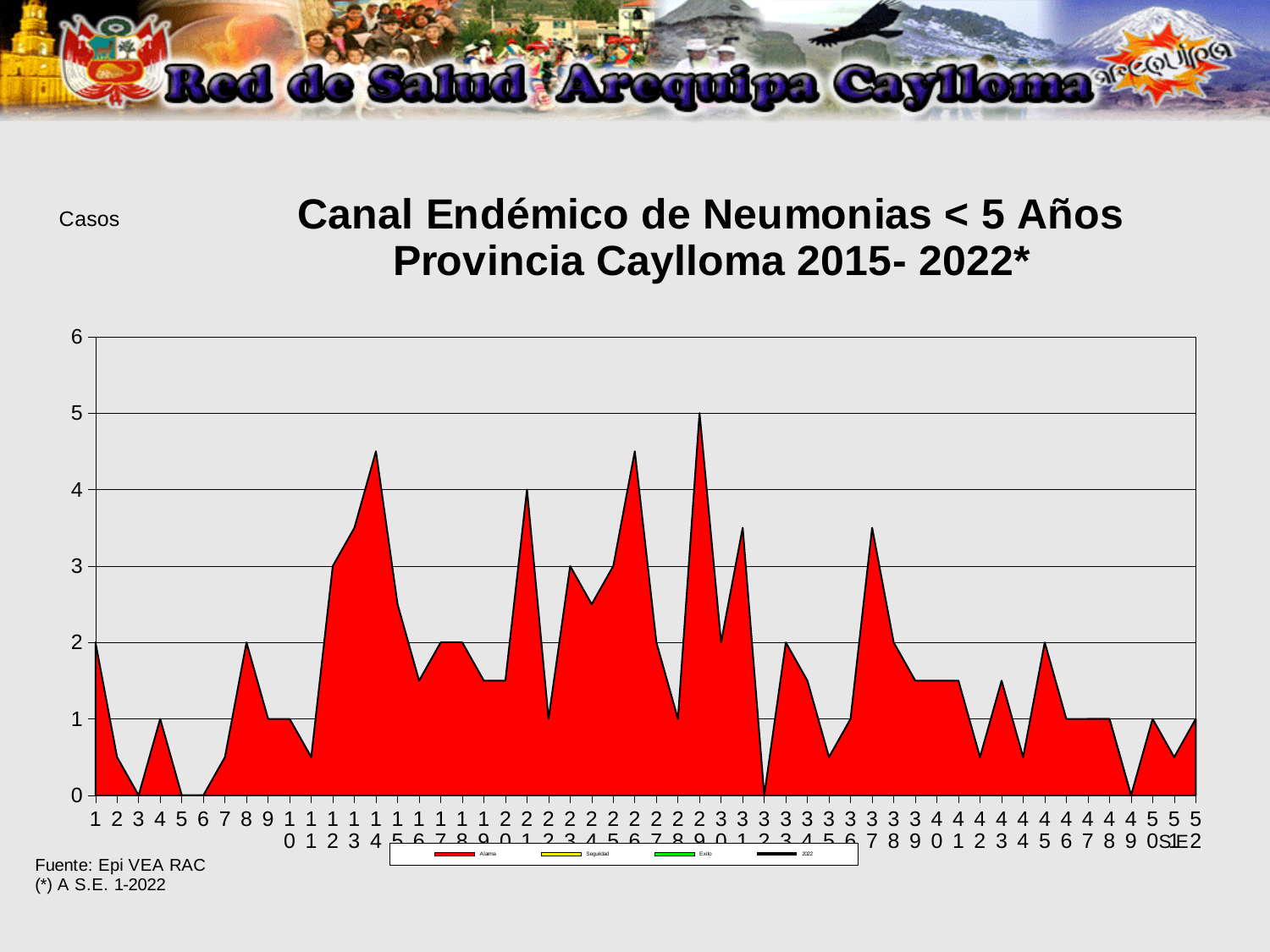
What is the title of the chart? Canal Endémico de Neumonias < 5 Años Provincia Caylloma 2015- 2022* What label is shown on the vertical axis of the chart? Casos Is the value at week 9 greater or less than 2? less Is the value at week 14 greater or less than 4? greater Which week has the larger value, week 29 or week 21? week 29 How many weeks are plotted along the x axis? 52 Do the values rise or fall from week 29 to week 32? fall What is the value at week 1? 2 What kind of chart is shown on the slide? area chart What is the value at week 6? 0 What value does the chart reach at week 29? 5 At which week on the x axis does the chart reach its highest value? 29